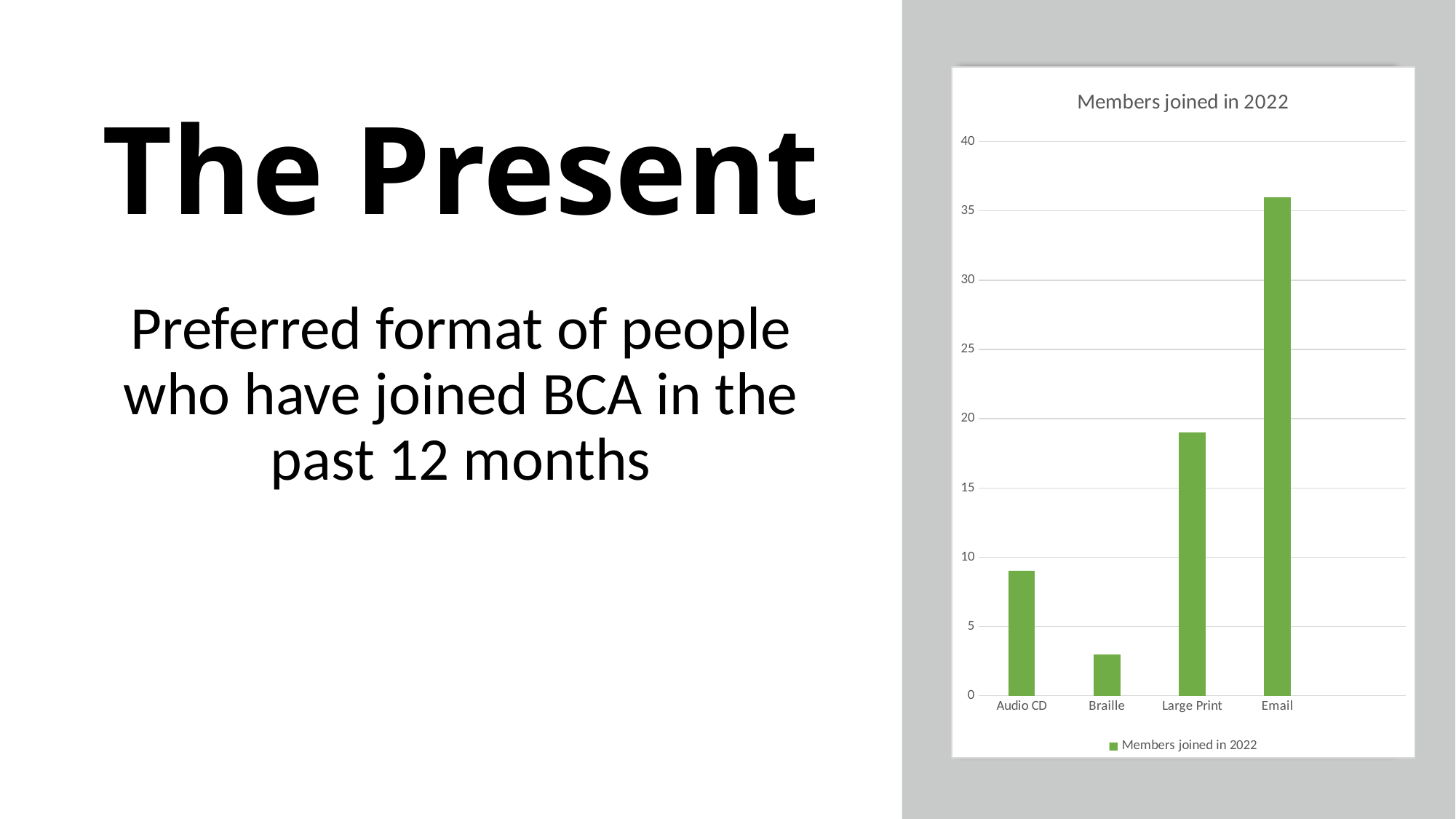
Which is larger, the value for Large Print or the value for Audio CD? Large Print Which category has the lowest value in the chart? Braille Which is larger, the value for Braille or the value for Audio CD? Audio CD Is the value for Audio CD greater or less than 10? less How many series does the chart legend list? 1 Is the value for Large Print greater or less than 15? greater Which category has the highest value in the chart? Email What is the title of the chart? Members joined in 2022 Is the value for Braille greater or less than 5? less What kind of chart is shown on the slide? bar chart How many categories are shown on the x axis of the chart? 4